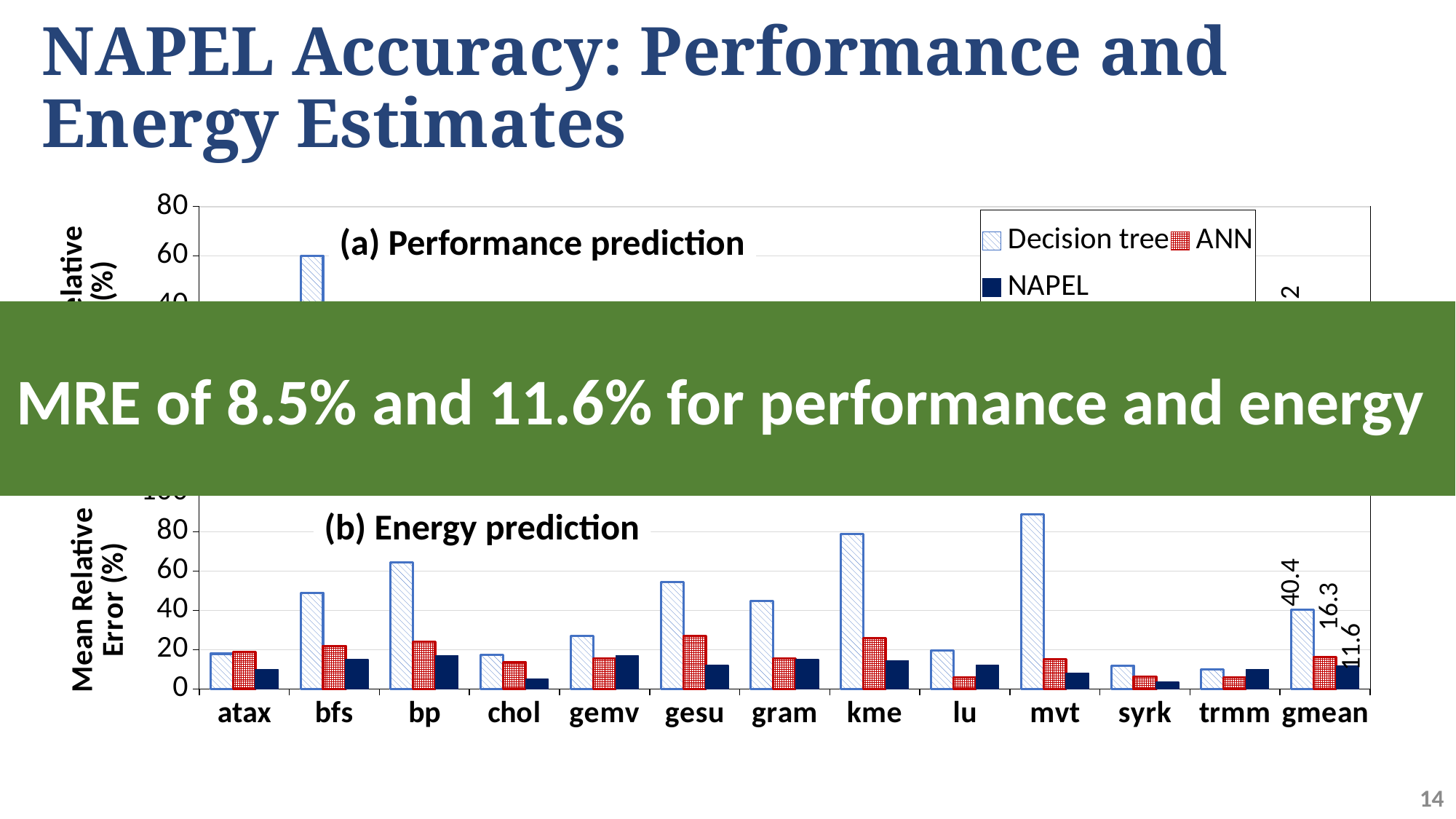
In the (b) Energy prediction chart, what is the Mean Relative Error for ANN at gmean? 16.3 In the (b) Energy prediction chart, is the Decision tree value for mvt greater or less than 80? greater How many series does the legend on the (a) Performance prediction chart list? 3 In the (b) Energy prediction chart, what is the Mean Relative Error for NAPEL at gmean? 11.6 In the (b) Energy prediction chart, what is the Mean Relative Error for Decision tree at gmean? 40.4 In the (b) Energy prediction chart, which is larger at gmean: the Decision tree value or the NAPEL value? Decision tree How many benchmark categories are shown on the x axis of the (b) Energy prediction chart? 13 In the (b) Energy prediction chart, what is the difference between the ANN and NAPEL values at gmean? 4.7 In the (b) Energy prediction chart, what is the difference between the Decision tree and ANN values at gmean? 24.1 In the (b) Energy prediction chart, is the ANN value for gesu greater or less than 40? less In the (b) Energy prediction chart, is the Decision tree value for kme greater or less than 60? greater In the (b) Energy prediction chart, which benchmark has the highest Decision tree error? mvt